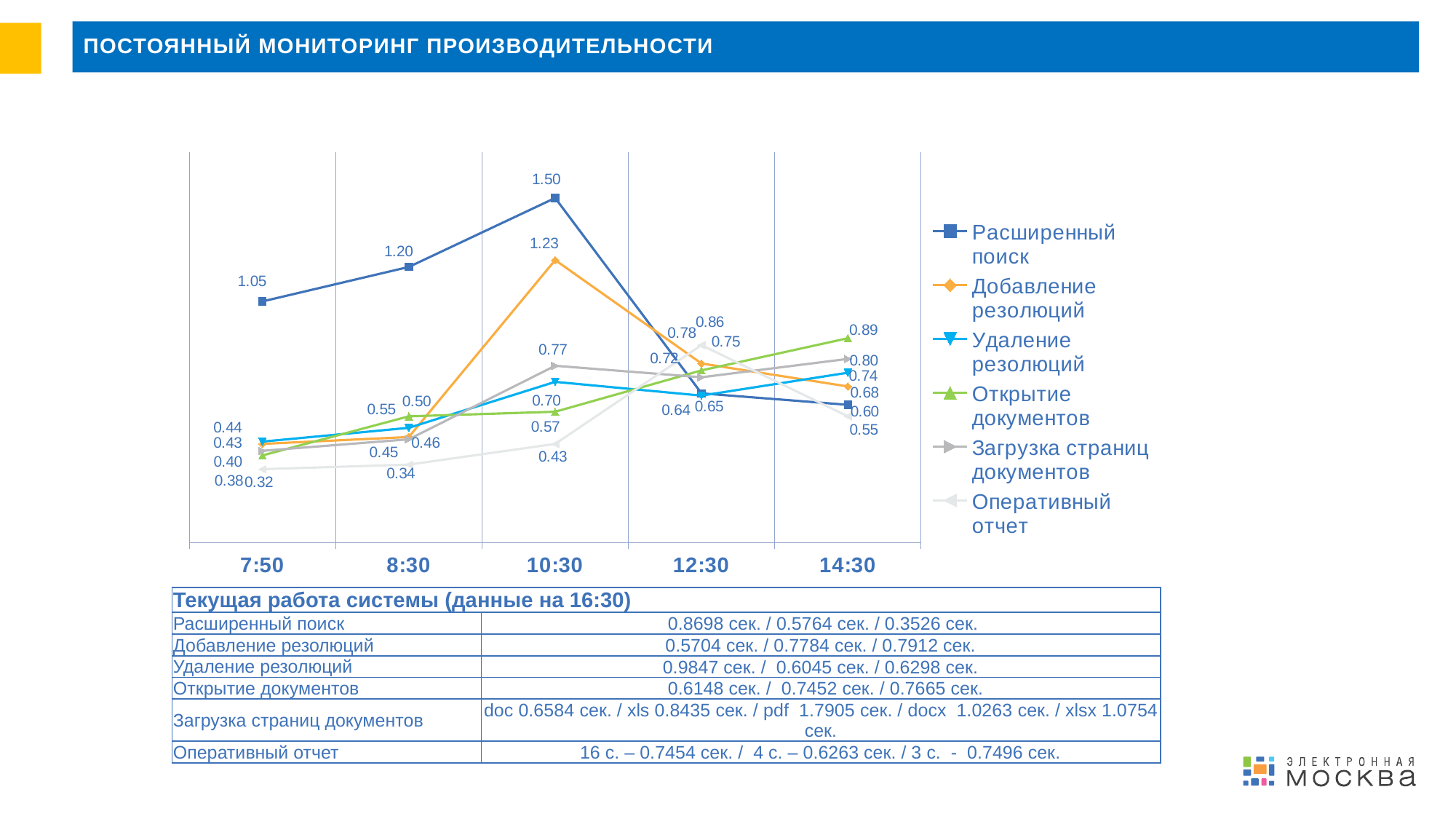
What is the value for Расширенный поиск at 7:50? 1.05 What is the value for Открытие документов at 14:30? 0.89 What is the value for Расширенный поиск at 10:30? 1.50 What is the value for Добавление резолюций at 10:30? 1.23 How many time points are shown on the x axis? 5 What kind of chart is shown on the slide? line chart At which time does Расширенный поиск have its lowest value? 14:30 Does the Расширенный поиск line rise or fall from 10:30 to 14:30? fall What is the difference between the Расширенный поиск values at 10:30 and 8:30? 0.30 At which time does Расширенный поиск reach its highest value? 10:30 What is the value for Оперативный отчет at 12:30? 0.86 How many series does the legend list? 6